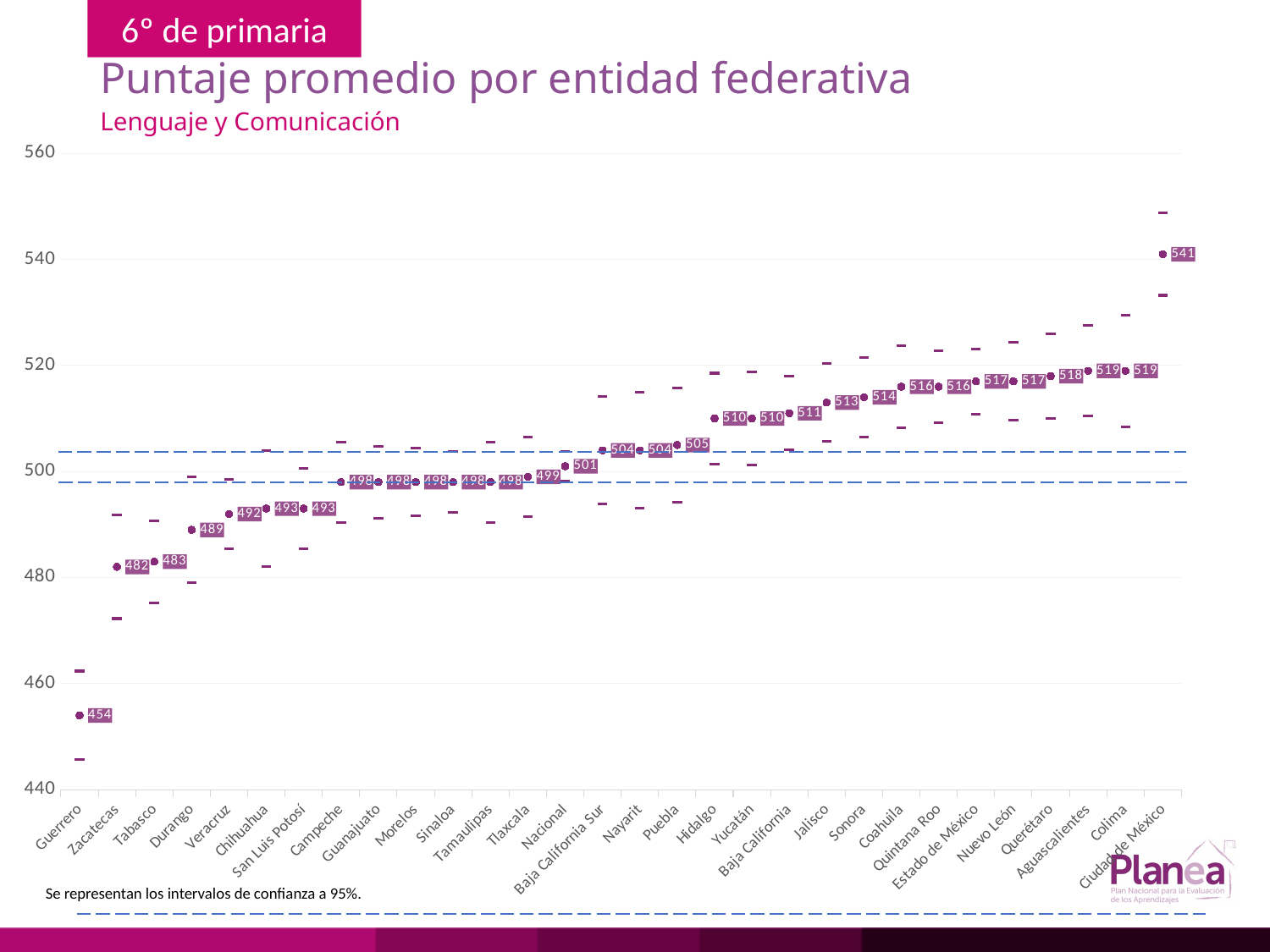
Which entity has the highest average score? Ciudad de México Which has a higher average score, Durango or Puebla? Puebla Is the value for Zacatecas greater or less than 500? less Which entity has the lowest average score? Guerrero What subject does the chart subtitle indicate? Lenguaje y Comunicación What is the average score for Ciudad de México? 541 What is the difference between the scores of Ciudad de México and Guerrero? 87 What is the average score for Jalisco? 513 What is the value shown for Nacional? 501 Do the values rise or fall from left to right along the x axis? rise What is the average score for Guerrero? 454 How many entities (including Nacional) are plotted along the x axis? 30